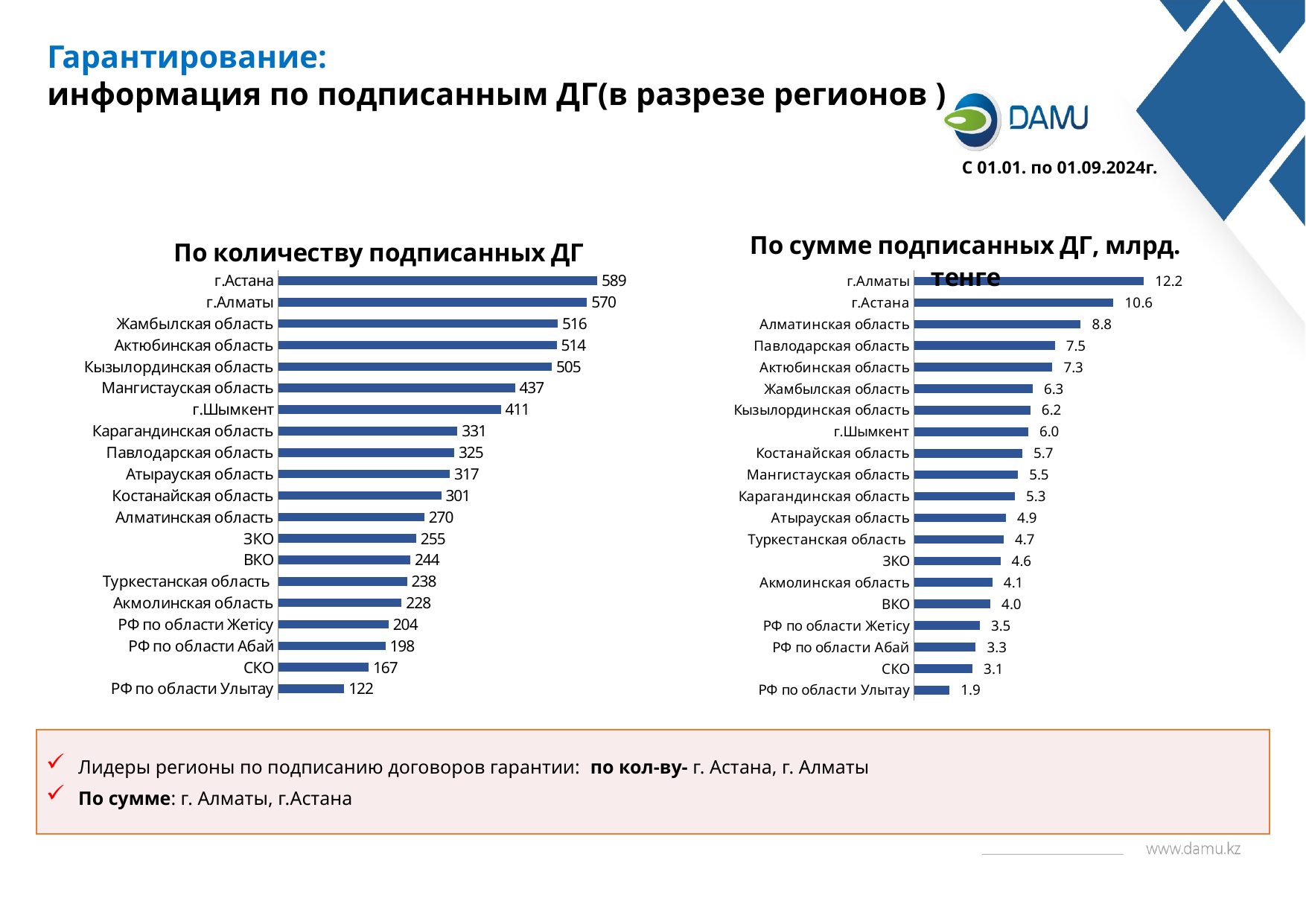
How many regions are shown in the chart 'По количеству подписанных ДГ'? 20 In the chart 'По сумме подписанных ДГ, млрд. тенге', which region has the lowest value? РФ по области Улытау What type of chart is 'По сумме подписанных ДГ, млрд. тенге'? Bar chart In the chart 'По сумме подписанных ДГ, млрд. тенге', what is the value for ЗКО? 4.6 In the chart 'По количеству подписанных ДГ', which is larger: Мангистауская область or г.Шымкент? Мангистауская область In the chart 'По сумме подписанных ДГ, млрд. тенге', what is the value for Павлодарская область? 7.5 In the chart 'По количеству подписанных ДГ', what is the value for СКО? 167 In the chart 'По сумме подписанных ДГ, млрд. тенге', what is the difference between г.Алматы and г.Астана? 1.6 In the chart 'По количеству подписанных ДГ', which region has the highest value? г.Астана In the chart 'По сумме подписанных ДГ, млрд. тенге', which is larger: Костанайская область or Карагандинская область? Костанайская область In the chart 'По количеству подписанных ДГ', what is the value for Кызылординская область? 505 In the chart 'По количеству подписанных ДГ', what is the difference between г.Астана and г.Алматы? 19